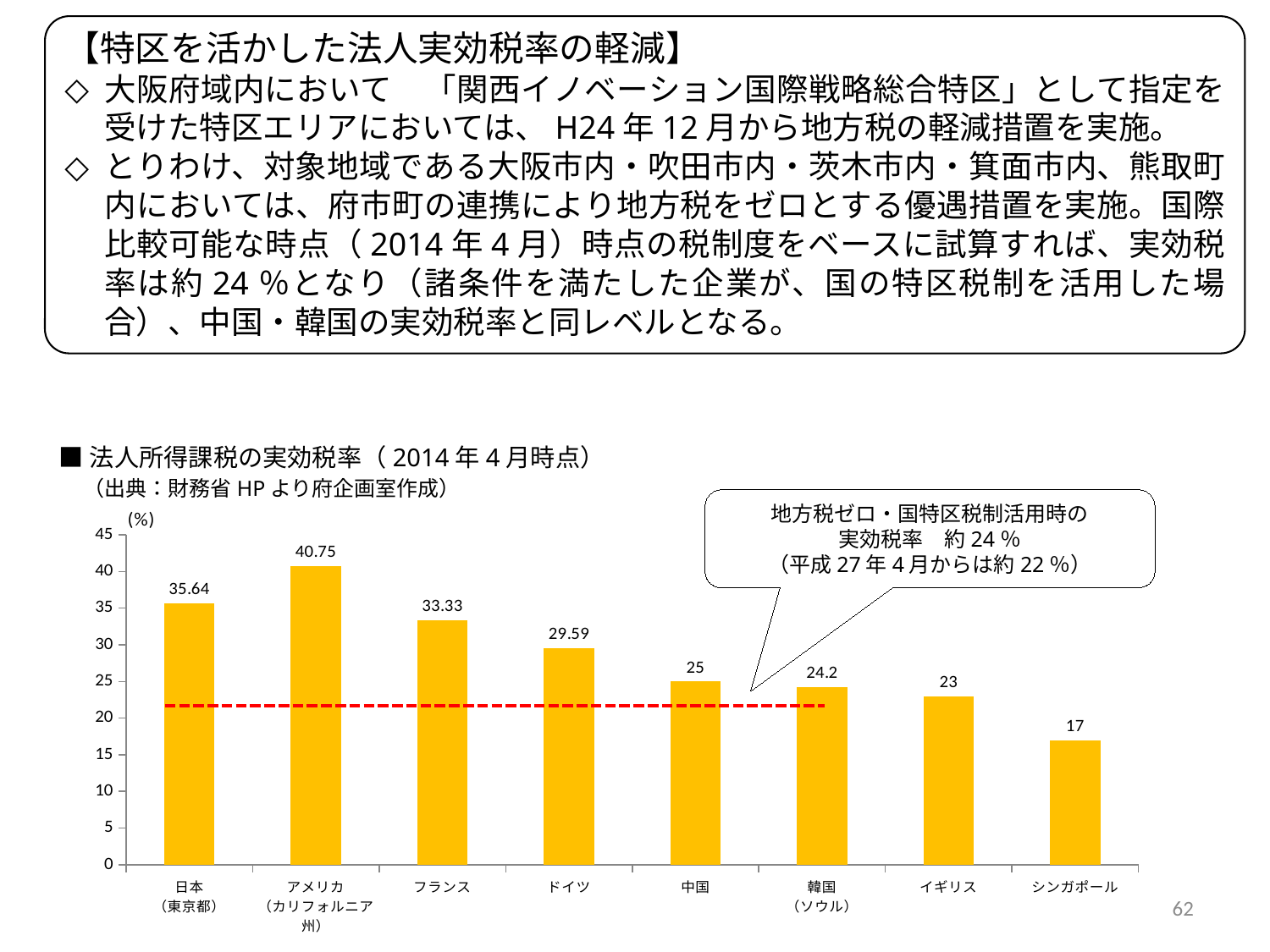
日本（東京都）の法人所得課税の実効税率はいくらですか？ 35.64 韓国（ソウル）の実効税率はいくらですか？ 24.2 フランスとドイツでは、どちらの実効税率が高いですか？ フランス グラフには何か国・地域が示されていますか？ 8 実効税率が最も低い国・地域はどこですか？ シンガポール 実効税率が最も高い国・地域はどこですか？ アメリカ（カリフォルニア州） グラフのタイトルは何ですか？ 法人所得課税の実効税率（2014年4月時点） 日本（東京都）とシンガポールの実効税率の差はいくらですか？ 18.64 アメリカ（カリフォルニア州）の実効税率はいくらですか？ 40.75 中国の実効税率は20より大きいですか、小さいですか？ greater このグラフはどの種類のグラフですか？ bar chart